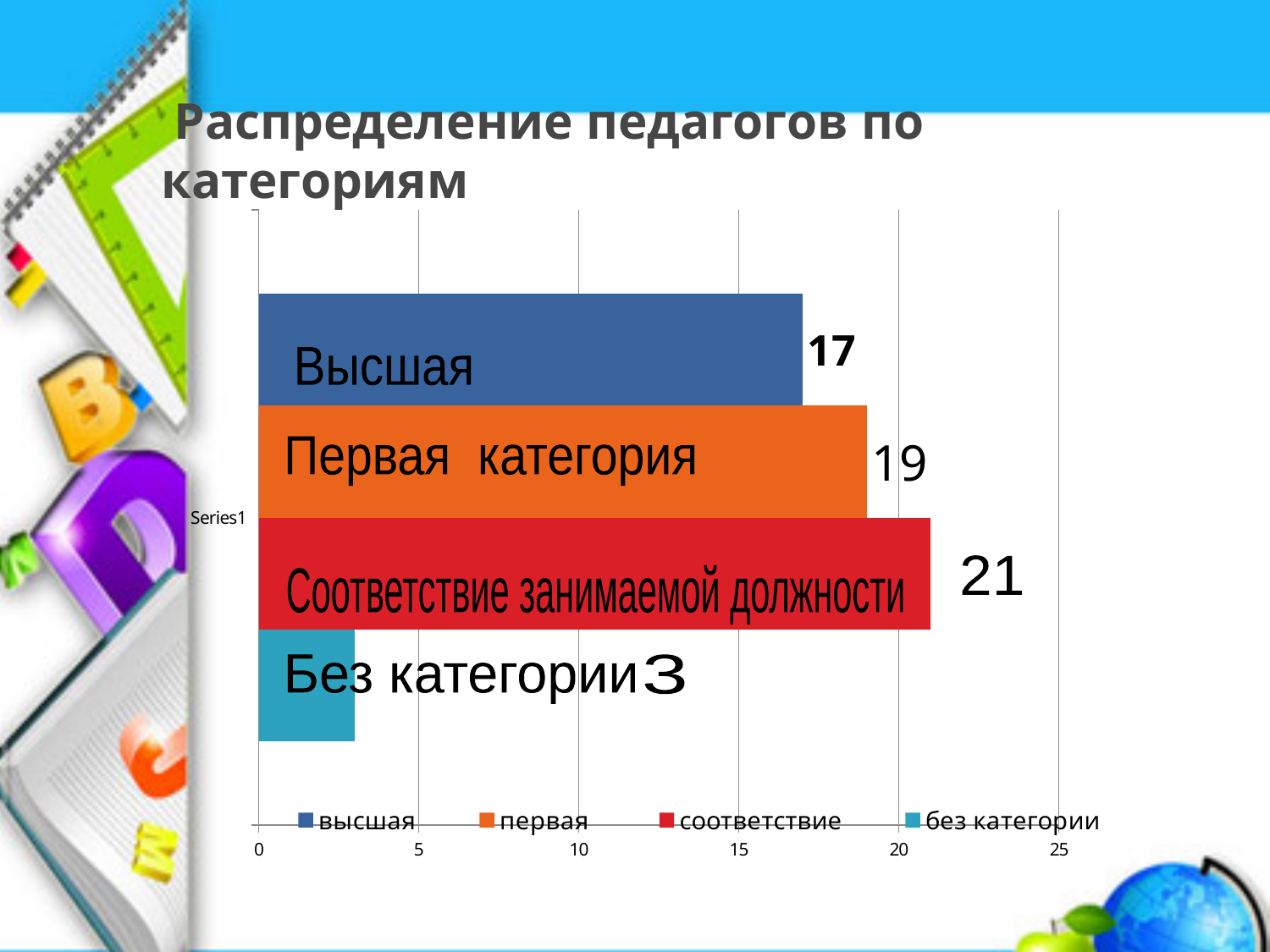
What is the difference between the values for Соответствие занимаемой должности and Высшая? 4 What is the value for Соответствие занимаемой должности? 21 What is the value for Без категории? 3 What is the value for Первая категория? 19 Is the value for Первая категория greater or less than 20? less Which category has the highest value? Соответствие занимаемой должности Which is larger, the value for Первая категория or the value for Высшая? Первая категория What is the title of the slide? Распределение педагогов по категориям What is the value for Высшая? 17 What type of chart is shown on the slide? bar chart Which category has the lowest value? Без категории How many bars are shown in the chart? 4